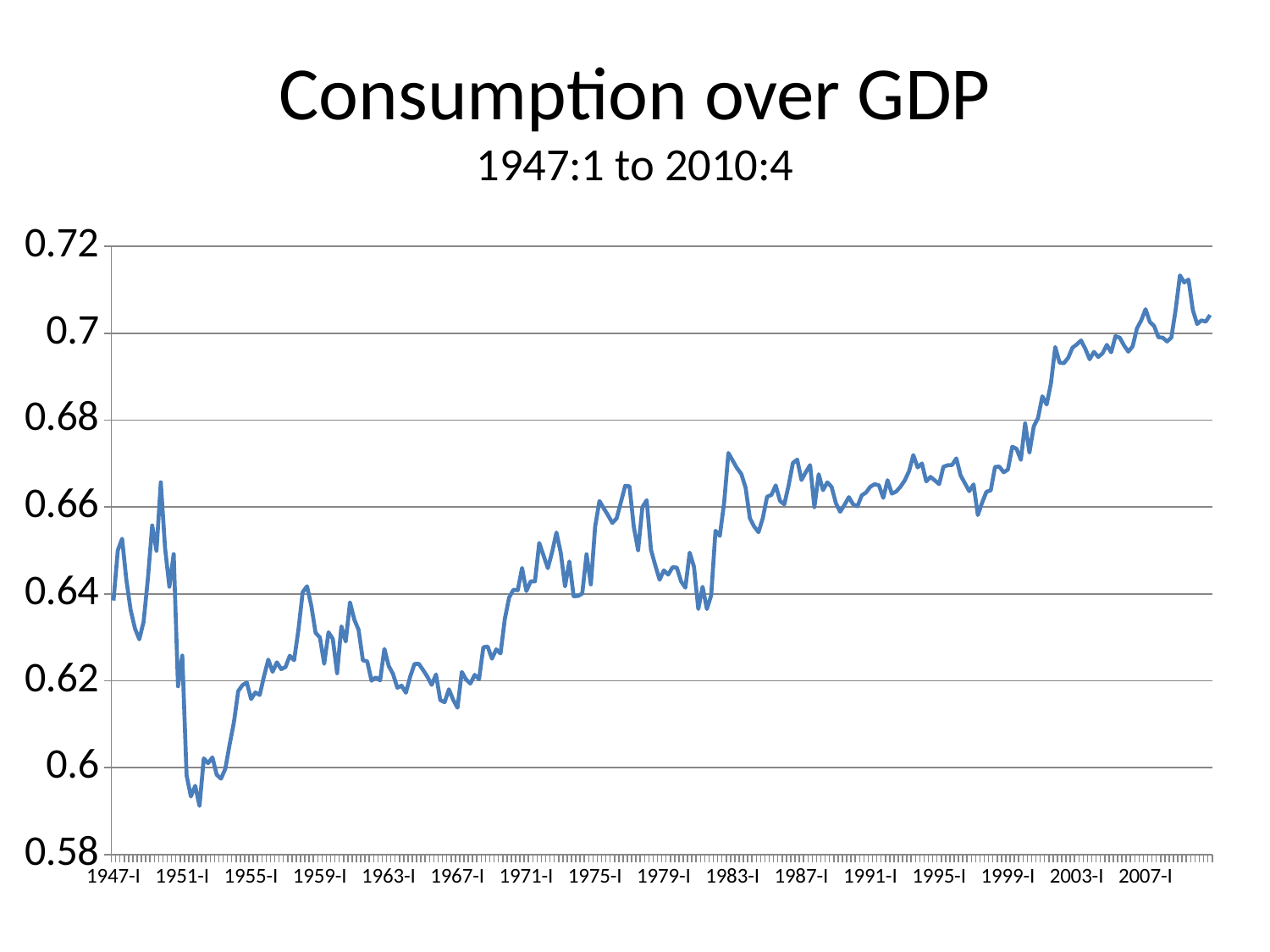
Is the value at 1967-I greater or less than 0.62? less Overall, do the values rise or fall from 1947-I to the end of the series? rise Is the lowest value on the chart greater or less than 0.6? less What kind of chart is shown on the slide? line chart What is the title of the chart? Consumption over GDP Is the value at 1955-I greater or less than 0.64? less What period does the subtitle say the chart covers? 1947:1 to 2010:4 Which is larger, the value at 2003-I or the value at 1955-I? 2003-I How many data series are plotted on the chart? 1